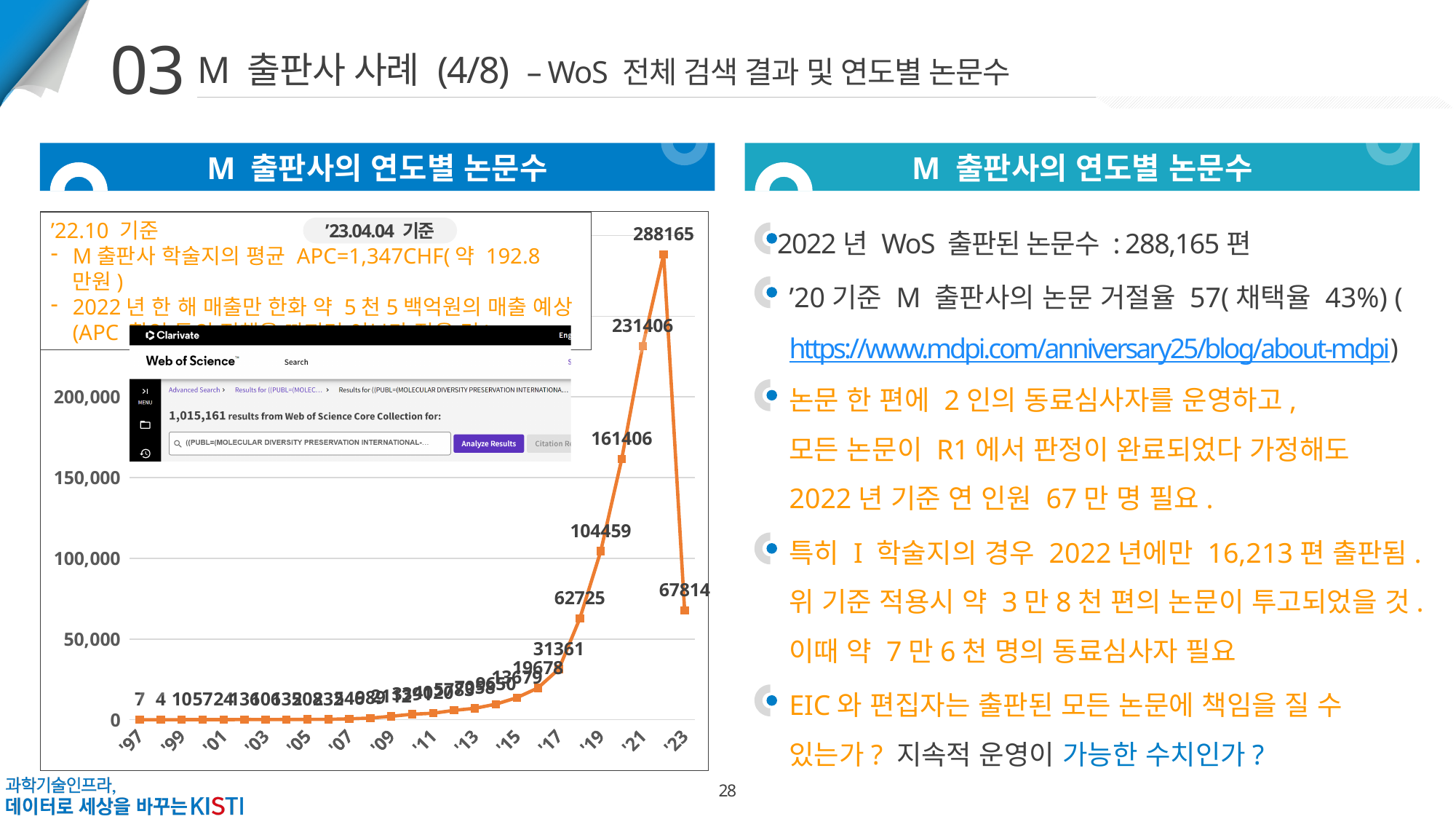
What is the number of papers shown for 2020? 161406 What is the number of papers shown for 2021? 231406 What is the number of papers shown for 2023? 67814 What is the title of the chart on the left of the slide? M 출판사의 연도별 논문수 What is the difference between the 2022 value and the 2021 value? 56759 What is the number of papers shown for 2017? 31361 Does the number of papers generally rise or fall from '97 to 2022? rise What is the number of papers shown for 2019? 104459 Which year has the larger value, 2021 or 2023? 2021 In which year does the chart reach its highest number of papers? 2022 What is the number of papers shown for 2022? 288165 What kind of chart is shown on the left of the slide? line chart